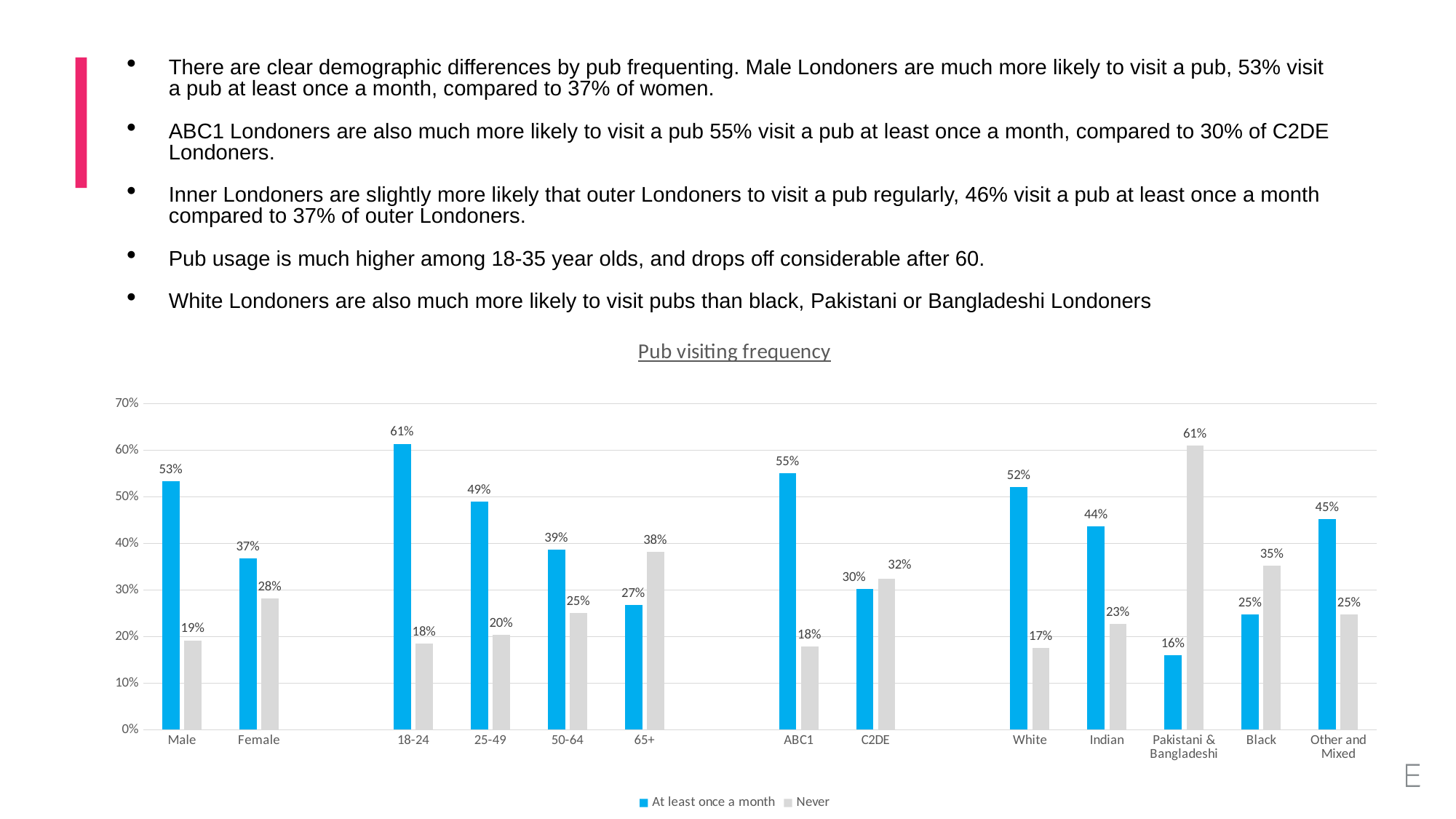
In the "Pub visiting frequency" chart, do the "At least once a month" values rise or fall across the age groups from 18-24 to 65+? Fall Which category has the lowest "At least once a month" value in the "Pub visiting frequency" chart? Pakistani & Bangladeshi How many categories are shown on the x axis of the "Pub visiting frequency" chart? 13 What is the "At least once a month" value for Male in the "Pub visiting frequency" chart? 53% What kind of chart is shown under the title "Pub visiting frequency"? Bar chart Which category has the highest "At least once a month" value in the "Pub visiting frequency" chart? 18-24 In the "Pub visiting frequency" chart, which is larger for Black Londoners: the "At least once a month" value or the "Never" value? Never What colour are the "Never" bars in the "Pub visiting frequency" chart? Grey Which category has the highest "Never" value in the "Pub visiting frequency" chart? Pakistani & Bangladeshi How many series does the legend of the "Pub visiting frequency" chart list? 2 What is the "Never" value for 65+ in the "Pub visiting frequency" chart? 38% What is the difference between the "At least once a month" values for ABC1 and C2DE in the "Pub visiting frequency" chart? 25%